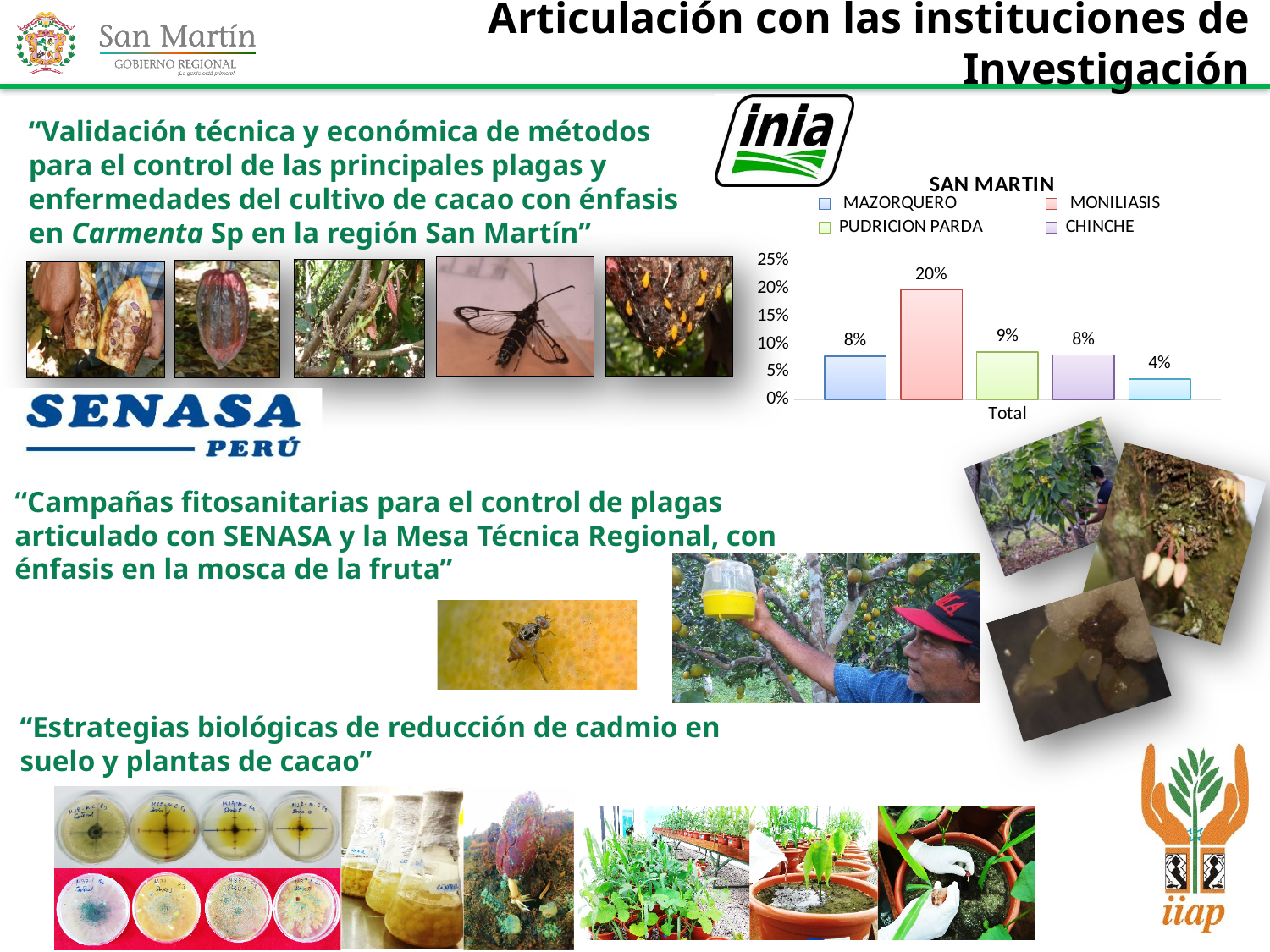
What is the difference between the values for MONILIASIS and PUDRICION PARDA? 11% Which is larger, the value for PUDRICION PARDA or the value for CHINCHE? PUDRICION PARDA What type of chart is shown on the slide? bar chart What is the value for MAZORQUERO in the chart? 8% What is the title of the chart? SAN MARTIN Is the value for MONILIASIS greater or less than 15%? greater What is the value for CHINCHE in the chart? 8% How many bars are plotted in the chart? 5 What is the value for PUDRICION PARDA in the chart? 9% What is the category label shown on the x axis of the chart? Total What is the value for MONILIASIS in the chart? 20% Which series has the highest value in the chart? MONILIASIS